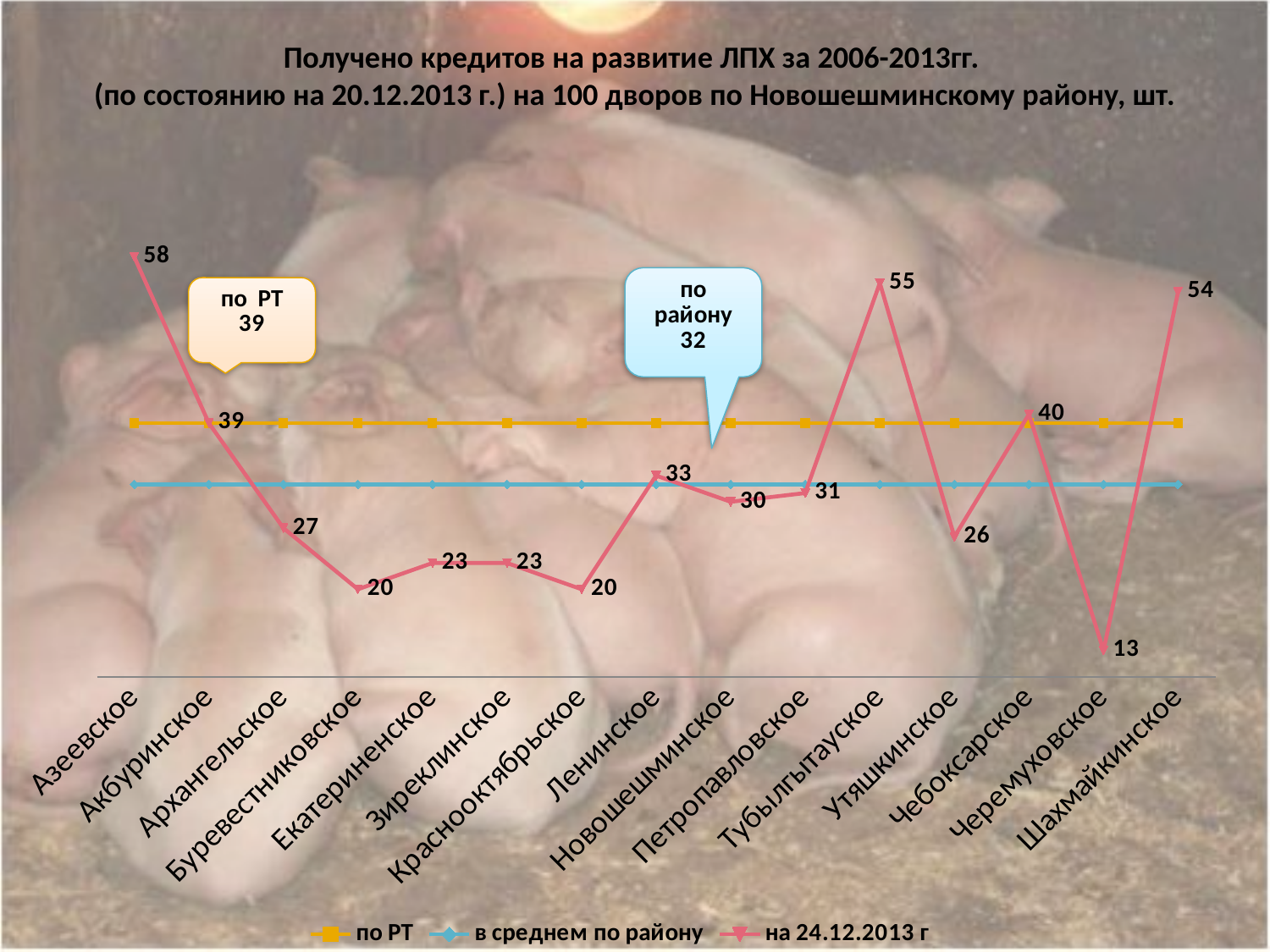
How many settlements are shown along the x axis? 15 What is the value for Черемуховское in the series 'на 24.12.2013 г'? 13 What is the value for Тубылгытауское in the series 'на 24.12.2013 г'? 55 Which settlement has the highest value in the series 'на 24.12.2013 г'? Азеевское Which is larger in the series 'на 24.12.2013 г': the value for Чебоксарское or the value for Утяшкинское? Чебоксарское Which settlement has the lowest value in the series 'на 24.12.2013 г'? Черемуховское What is the difference between the values for Шахмайкинское and Черемуховское in the series 'на 24.12.2013 г'? 41 What type of chart is shown on the slide? line chart What constant value does the 'по РТ' line show? 39 What is the value for Азеевское in the series 'на 24.12.2013 г'? 58 What constant value does the 'в среднем по району' line show? 32 How many series does the legend list? 3